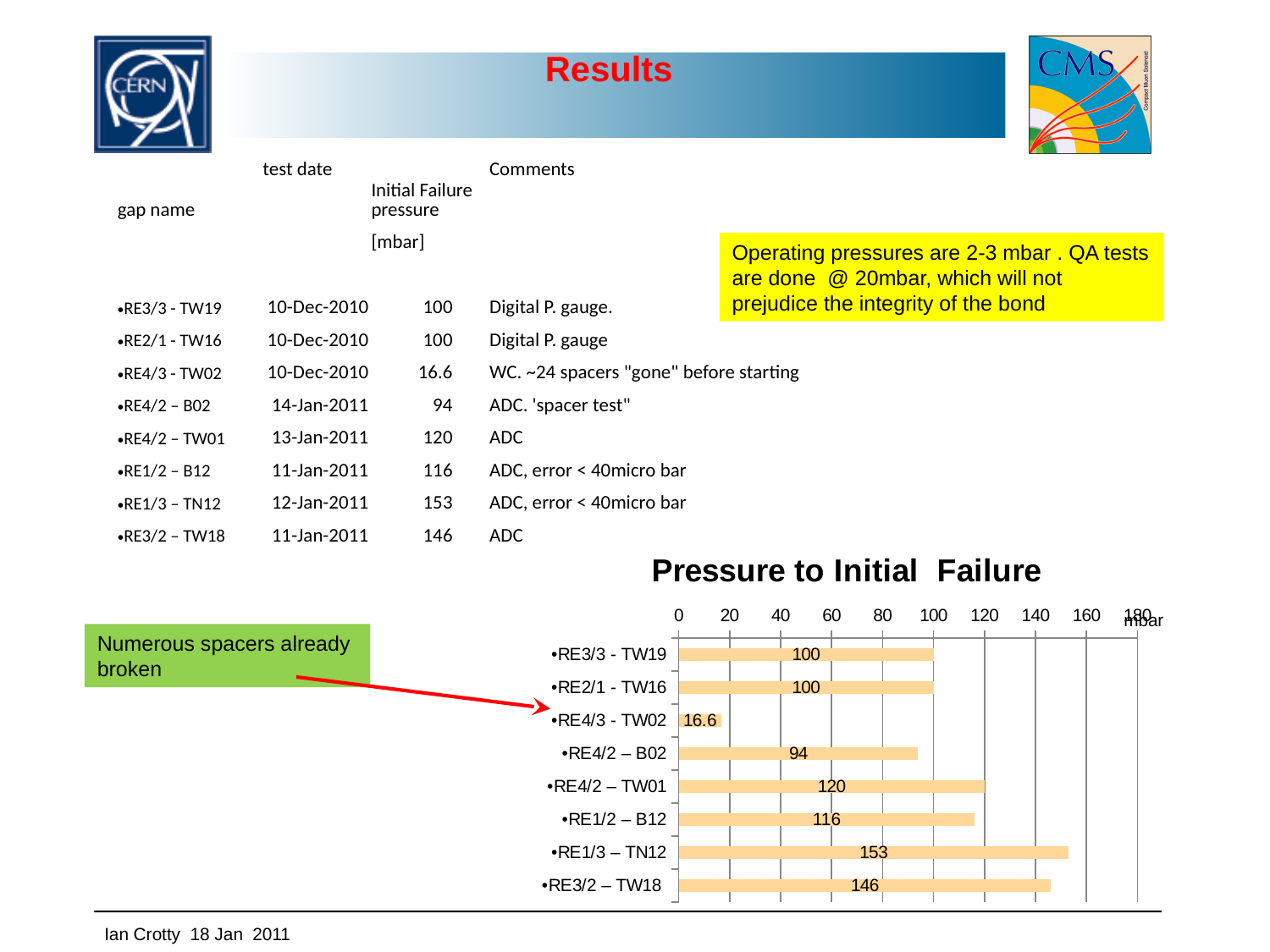
What kind of chart is used to show the pressure to initial failure? bar chart What is the difference between the pressure to initial failure for RE1/3 – TN12 and RE3/2 – TW18? 7 Which gap has the lowest pressure to initial failure? RE4/3 - TW02 How many gaps are shown in the chart? 8 What is the title of the chart? Pressure to Initial Failure Which gap has the highest pressure to initial failure? RE1/3 – TN12 What unit is shown on the chart's value axis? mbar What is the pressure to initial failure for RE1/3 – TN12? 153 Which has a higher pressure to initial failure, RE4/2 – B02 or RE1/2 – B12? RE1/2 – B12 Is the value for RE3/2 – TW18 greater or less than 140? greater What is the pressure to initial failure for RE4/2 – TW01? 120 What is the pressure to initial failure for RE4/3 - TW02? 16.6